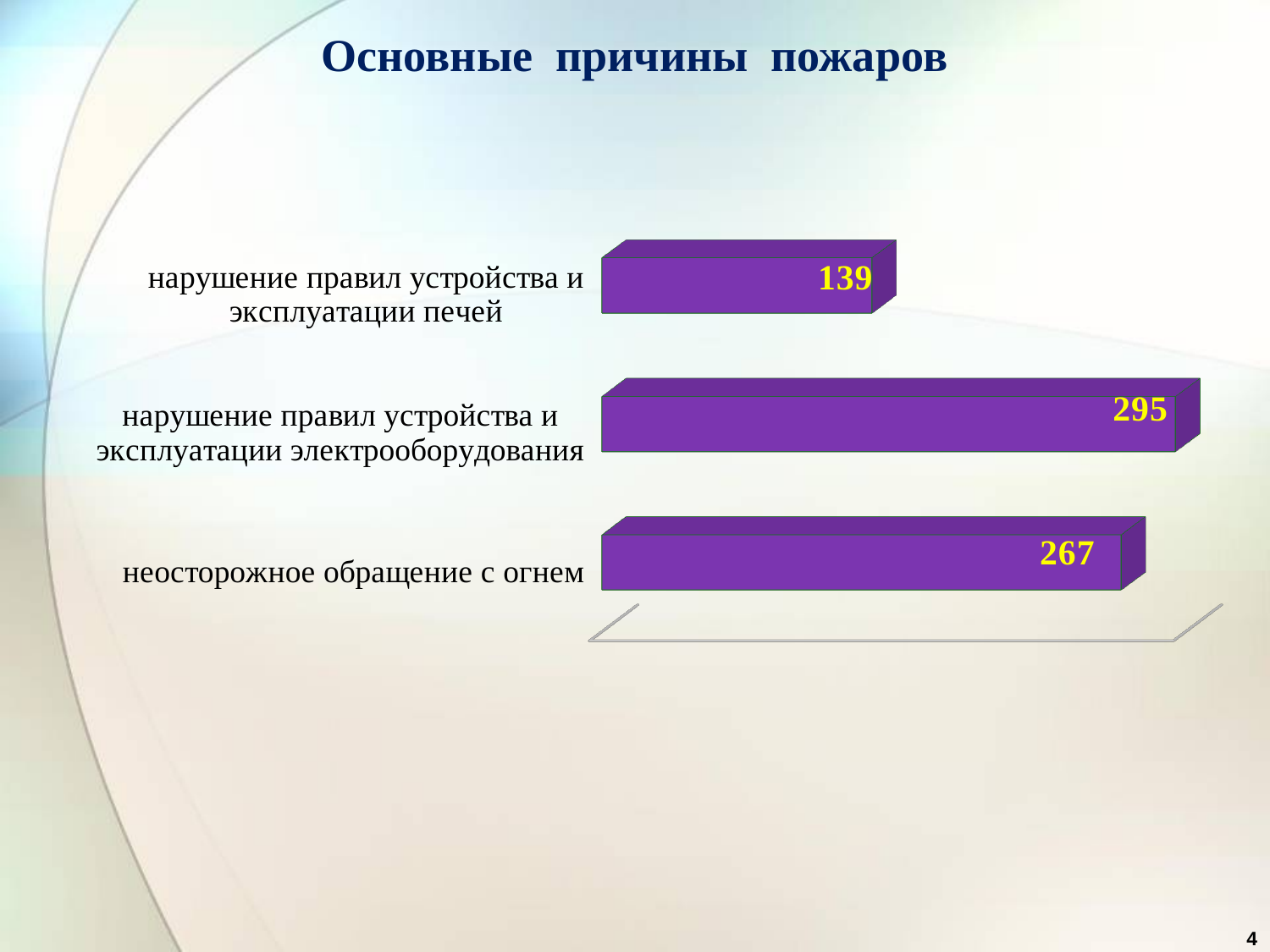
Which is larger: the value for "неосторожное обращение с огнем" or for "нарушение правил устройства и эксплуатации печей"? неосторожное обращение с огнем What colour are the bars in the chart? purple What is the difference between the values for "неосторожное обращение с огнем" and "нарушение правил устройства и эксплуатации печей"? 128 What is the value for "нарушение правил устройства и эксплуатации печей"? 139 Which category has the lowest value? нарушение правил устройства и эксплуатации печей What is the value for "неосторожное обращение с огнем"? 267 What is the title of the slide? Основные причины пожаров Which category has the highest value? нарушение правил устройства и эксплуатации электрооборудования How many categories are shown in the chart? 3 What is the value for "нарушение правил устройства и эксплуатации электрооборудования"? 295 What is the difference between the values for "нарушение правил устройства и эксплуатации электрооборудования" and "неосторожное обращение с огнем"? 28 What kind of chart is shown on the slide? bar chart